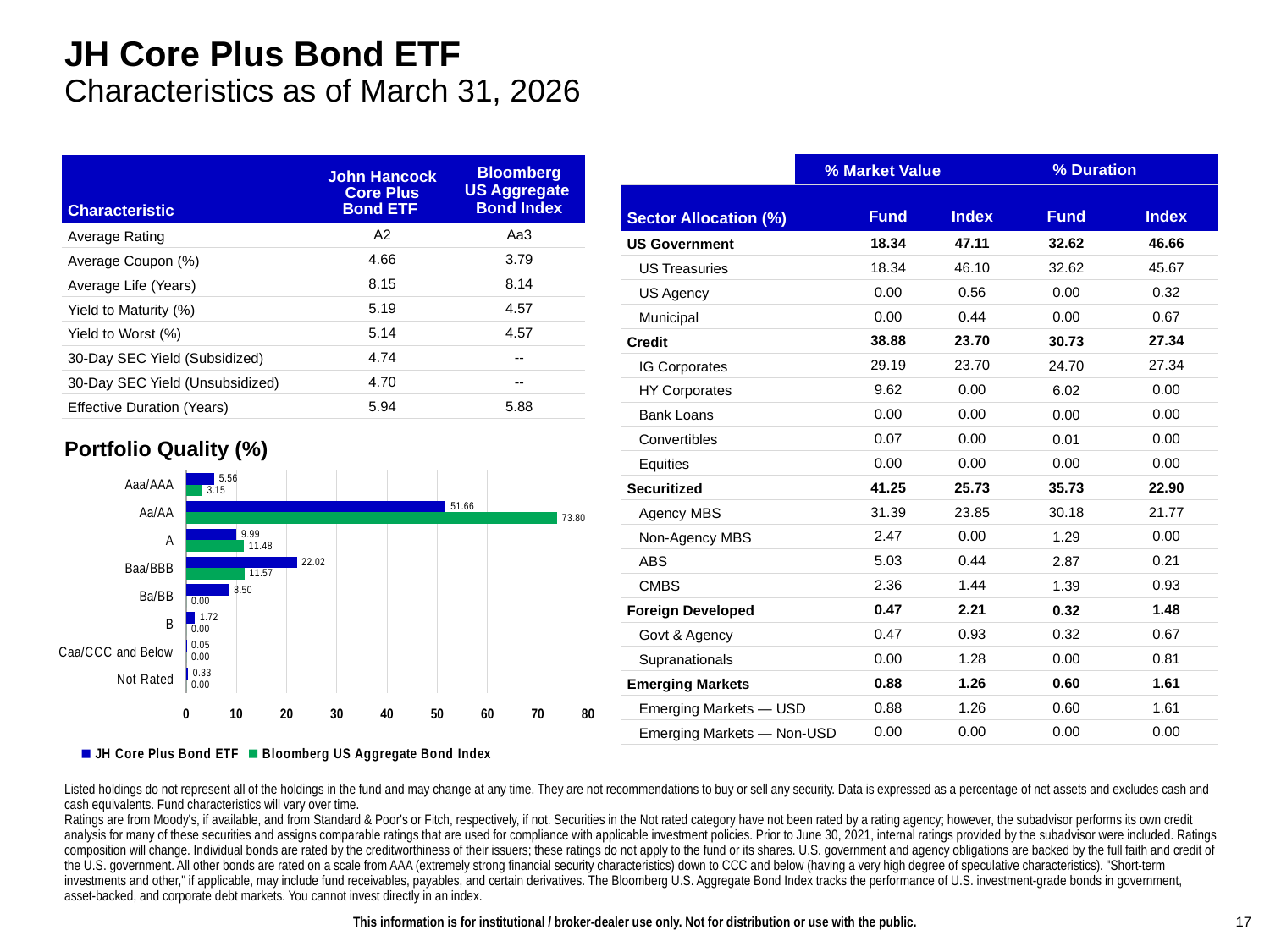
In the Portfolio Quality (%) chart, what is the value for JH Core Plus Bond ETF in the Baa/BBB category? 22.02 In the Portfolio Quality (%) chart, what is the difference between the Bloomberg US Aggregate Bond Index and JH Core Plus Bond ETF values in the Aa/AA category? 22.14 In the Portfolio Quality (%) chart, what is the value for JH Core Plus Bond ETF in the Aa/AA category? 51.66 What kind of chart is the Portfolio Quality (%) chart? Bar chart In the Portfolio Quality (%) chart, which series has the larger value in the Baa/BBB category? JH Core Plus Bond ETF How many series does the legend of the Portfolio Quality (%) chart list? 2 In the Portfolio Quality (%) chart, is the JH Core Plus Bond ETF value for Aa/AA greater or less than 50? greater In the Portfolio Quality (%) chart, what is the value for the Bloomberg US Aggregate Bond Index in the Aa/AA category? 73.80 In the Portfolio Quality (%) chart, what is the value for the Bloomberg US Aggregate Bond Index in the A category? 11.48 How many rating categories are shown in the Portfolio Quality (%) chart? 8 In the Portfolio Quality (%) chart, which category has the highest value for JH Core Plus Bond ETF? Aa/AA In the Portfolio Quality (%) chart, which category has the lowest value for JH Core Plus Bond ETF? Caa/CCC and Below